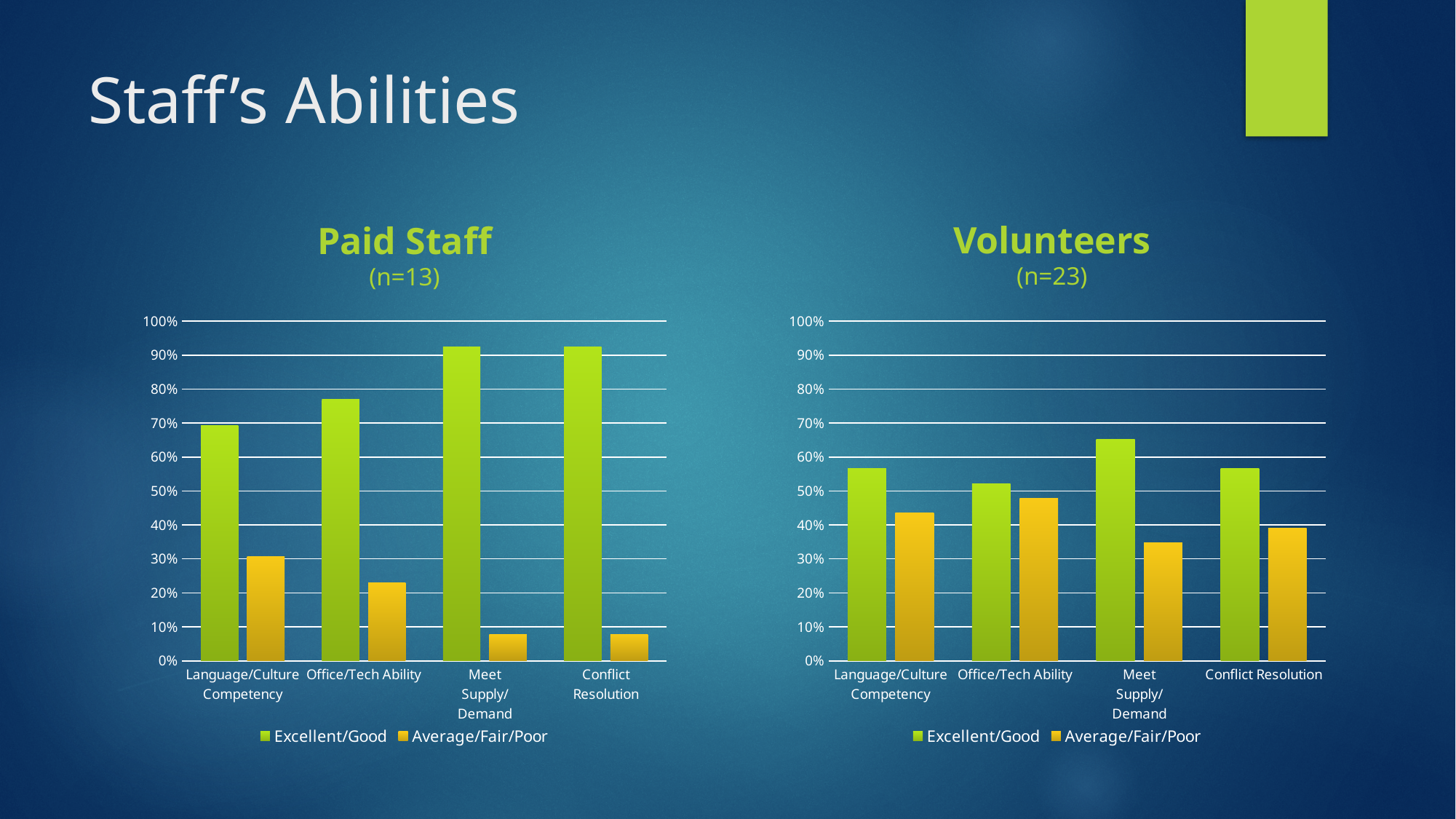
How many categories are shown on the x axis of the Paid Staff chart? 4 In the Volunteers chart, which category has the lowest Average/Fair/Poor value? Meet Supply/Demand In the Paid Staff chart, is the Average/Fair/Poor value for Meet Supply/Demand greater or less than 10%? less In the Volunteers chart, is the Average/Fair/Poor value for Language/Culture Competency greater or less than 40%? greater What sample size is shown under the Volunteers chart title? n=23 In the Paid Staff chart, is the Excellent/Good value for Office/Tech Ability greater or less than 70%? greater In the Volunteers chart, which category has the highest Excellent/Good value? Meet Supply/Demand In the Volunteers chart, which is larger for Office/Tech Ability: Excellent/Good or Average/Fair/Poor? Excellent/Good In the Paid Staff chart, which category has the lowest Excellent/Good value? Language/Culture Competency How many series does the legend of the Volunteers chart list? 2 In the Paid Staff chart, which category has the highest Average/Fair/Poor value? Language/Culture Competency What kind of chart is the Paid Staff chart? bar chart